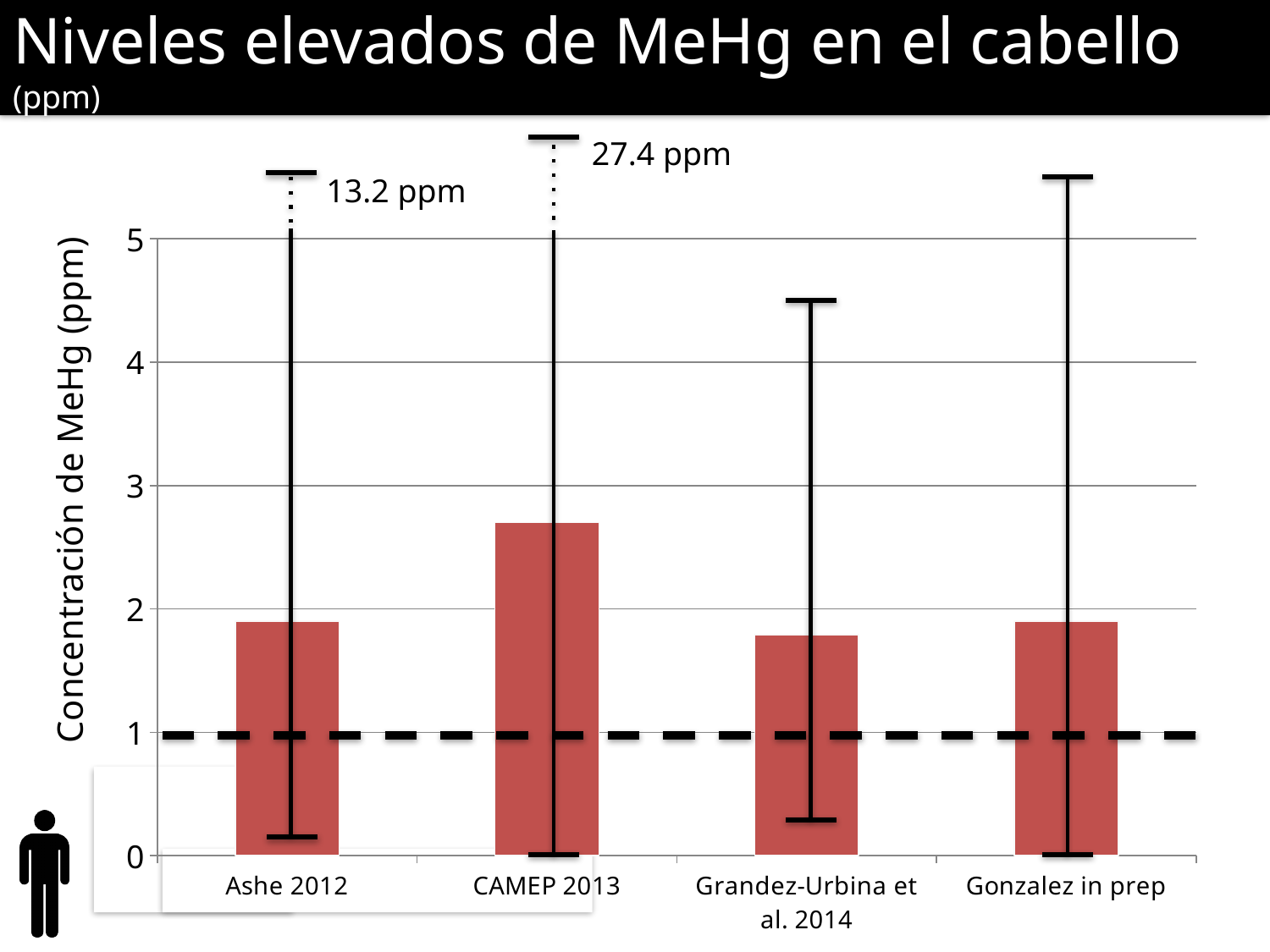
Is the bar value for CAMEP 2013 greater or less than 2? greater What is the label of the y axis of the chart? Concentración de MeHg (ppm) What is the title of the slide containing the chart? Niveles elevados de MeHg en el cabello What maximum value is annotated at the top of the error bar for Ashe 2012? 13.2 ppm Is the bar value for Grandez-Urbina et al. 2014 greater or less than 2? less Is the bar value for Ashe 2012 greater or less than 2? less What maximum value is annotated at the top of the error bar for CAMEP 2013? 27.4 ppm What kind of chart is shown on the slide? bar chart Which study has the highest bar in the chart? CAMEP 2013 How many studies (categories) are shown on the x axis of the chart? 4 Which bar is taller, CAMEP 2013 or Grandez-Urbina et al. 2014? CAMEP 2013